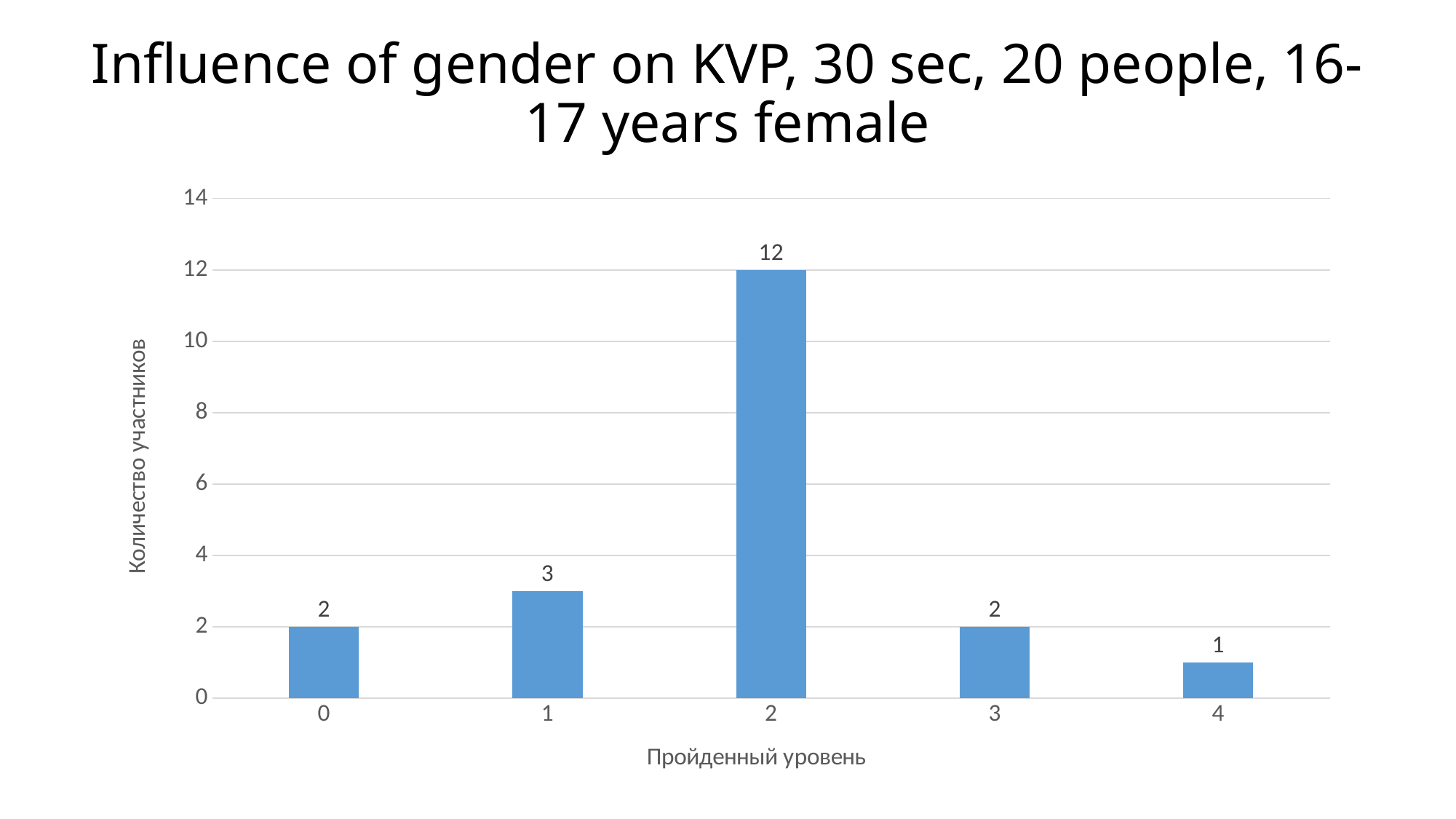
How many levels (categories) are shown on the x axis? 5 Which has more participants, level 1 or level 3? Level 1 What is the value shown for level 4? 1 What is the difference between the number of participants at level 2 and at level 1? 9 What is the title of the chart on the slide? Influence of gender on KVP, 30 sec, 20 people, 16-17 years female What is the number of participants for level 0? 2 What type of chart is shown on the slide? Bar chart What is the label of the x axis? Пройденный уровень Which level has the lowest number of participants? 4 Is the value for level 2 greater or less than 10? greater How many participants passed level 2? 12 Which level has the highest number of participants? 2